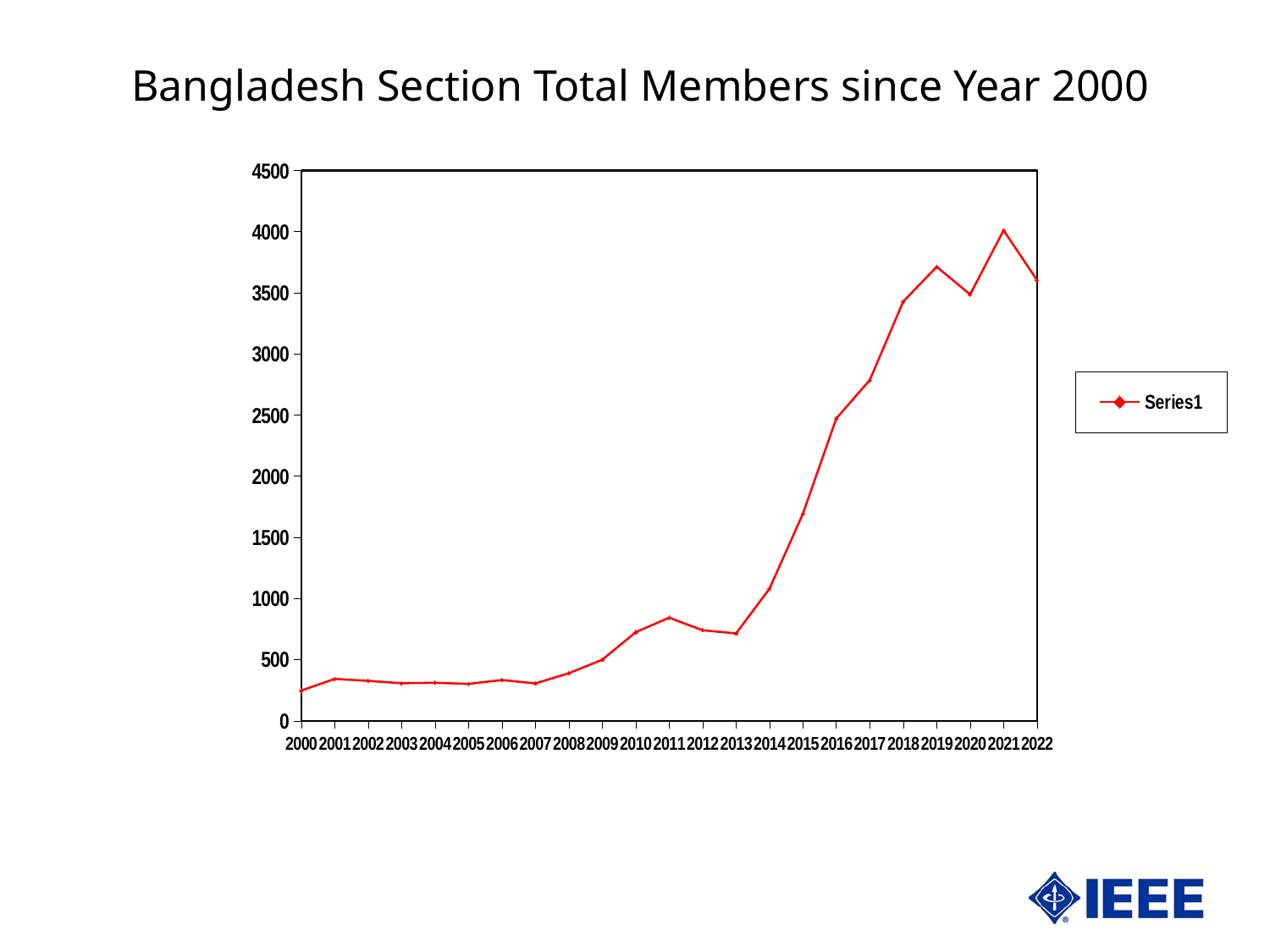
What kind of chart is shown on the slide? line chart In which year is the total membership highest? 2021 What is the title of the chart? Bangladesh Section Total Members since Year 2000 Overall, do the values rise or fall from 2000 to 2022? rise How many years are plotted along the x axis? 23 What is the name of the series shown in the legend? Series1 Which year has the larger value, 2019 or 2020? 2019 Is the value for 2013 greater or less than 1000? less How many series does the legend list? 1 Which year has the larger value, 2021 or 2022? 2021 Is the value for 2021 greater or less than 3500? greater Is the value for 2017 greater or less than 2500? greater